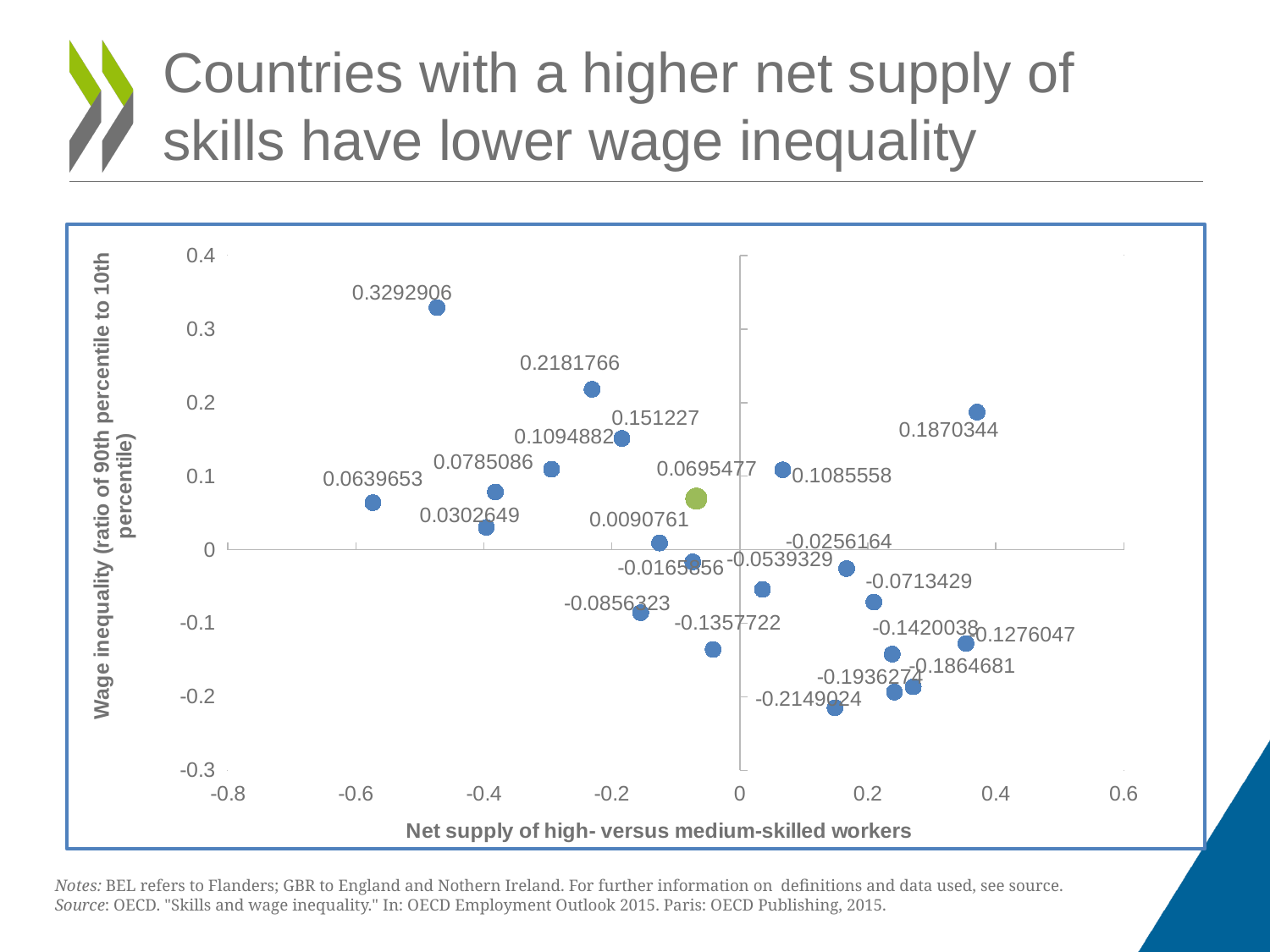
What is the title of the x axis? Net supply of high- versus medium-skilled workers What is the data label of the green point on the chart? 0.0695477 What is the difference between the highest labelled value (0.3292906) and the lowest labelled value (-0.2149024)? 0.544193 As net supply of high- versus medium-skilled workers increases along the x axis, does wage inequality generally rise or fall? Fall How many data points are plotted on the chart? 22 What kind of chart is shown on the slide? Scatter chart What is the title of the y axis? Wage inequality (ratio of 90th percentile to 10th percentile) Is the x-axis value of the point labelled 0.3292906 greater or less than -0.4? less What is the highest wage inequality value labelled on the chart? 0.3292906 Which is larger, the value labelled 0.2181766 or the value labelled 0.1870344? 0.2181766 What is the lowest wage inequality value labelled on the chart? -0.2149024 Is the x-axis value of the point labelled 0.1870344 greater or less than 0.2? greater